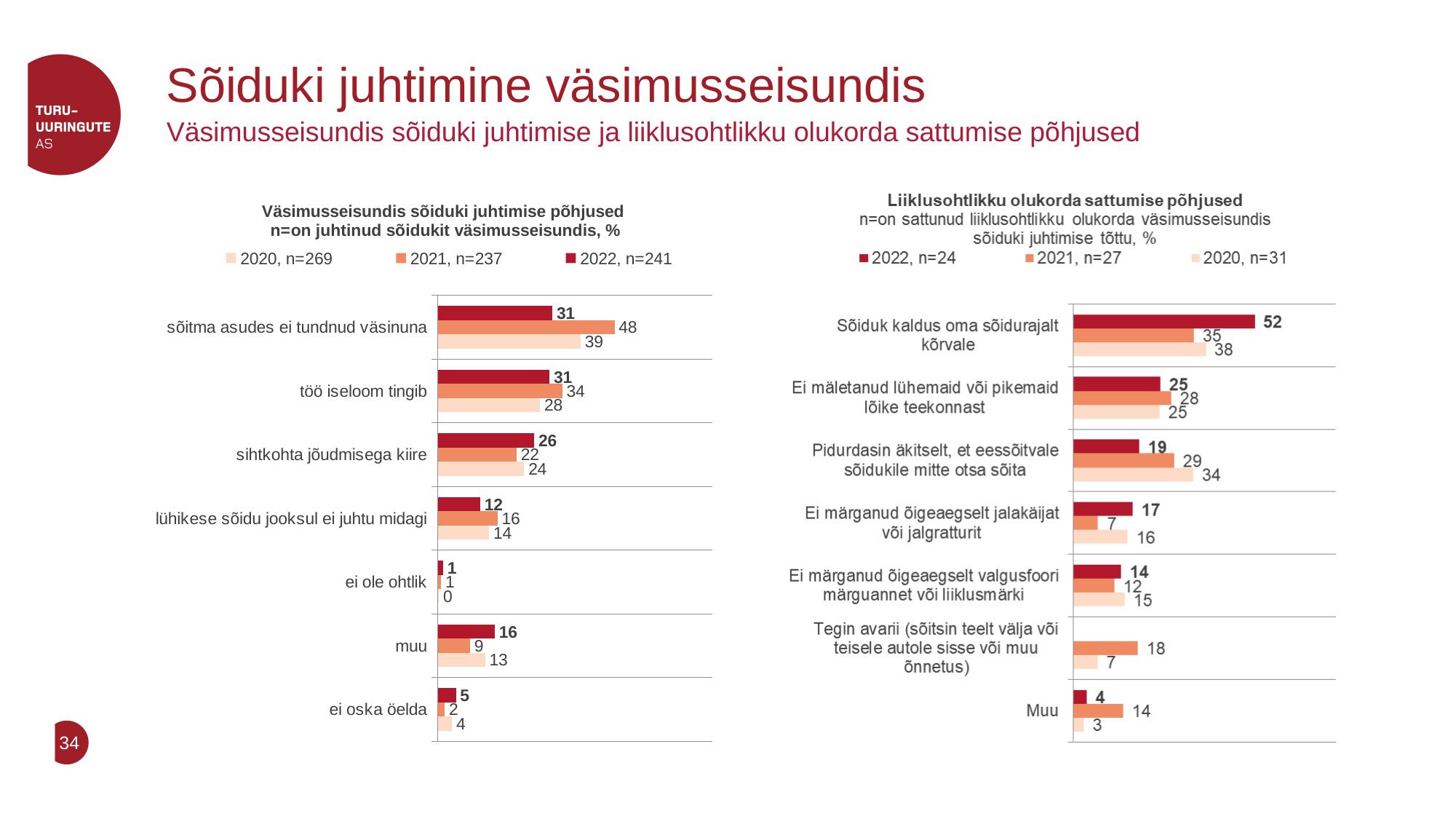
In the left chart (Väsimusseisundis sõiduki juhtimise põhjused), what is the 2021 value for "sõitma asudes ei tundnud väsinuna"? 48 In the left chart (Väsimusseisundis sõiduki juhtimise põhjused), what is the 2022 value for "muu"? 16 What type of chart is the left chart (Väsimusseisundis sõiduki juhtimise põhjused)? bar chart In the right chart (Liiklusohtlikku olukorda sattumise põhjused), what is the 2020 value for "Pidurdasin äkitselt, et eessõitvale sõidukile mitte otsa sõita"? 34 In the left chart (Väsimusseisundis sõiduki juhtimise põhjused), how many categories are shown? 7 In the left chart (Väsimusseisundis sõiduki juhtimise põhjused), which category has the lowest 2022 value? ei ole ohtlik In the right chart (Liiklusohtlikku olukorda sattumise põhjused), which is larger for "Ei märganud õigeaegselt jalakäijat või jalgratturit": the 2022 value or the 2021 value? 2022 In the right chart (Liiklusohtlikku olukorda sattumise põhjused), what is the difference between the 2021 and 2022 values for "Muu"? 10 In the right chart (Liiklusohtlikku olukorda sattumise põhjused), what is the 2022 value for "Sõiduk kaldus oma sõidurajalt kõrvale"? 52 In the left chart (Väsimusseisundis sõiduki juhtimise põhjused), what is the difference between the 2021 and 2022 values for "sõitma asudes ei tundnud väsinuna"? 17 In the right chart (Liiklusohtlikku olukorda sattumise põhjused), how many series does the legend list? 3 In the left chart (Väsimusseisundis sõiduki juhtimise põhjused), which category has the highest 2021 value? sõitma asudes ei tundnud väsinuna